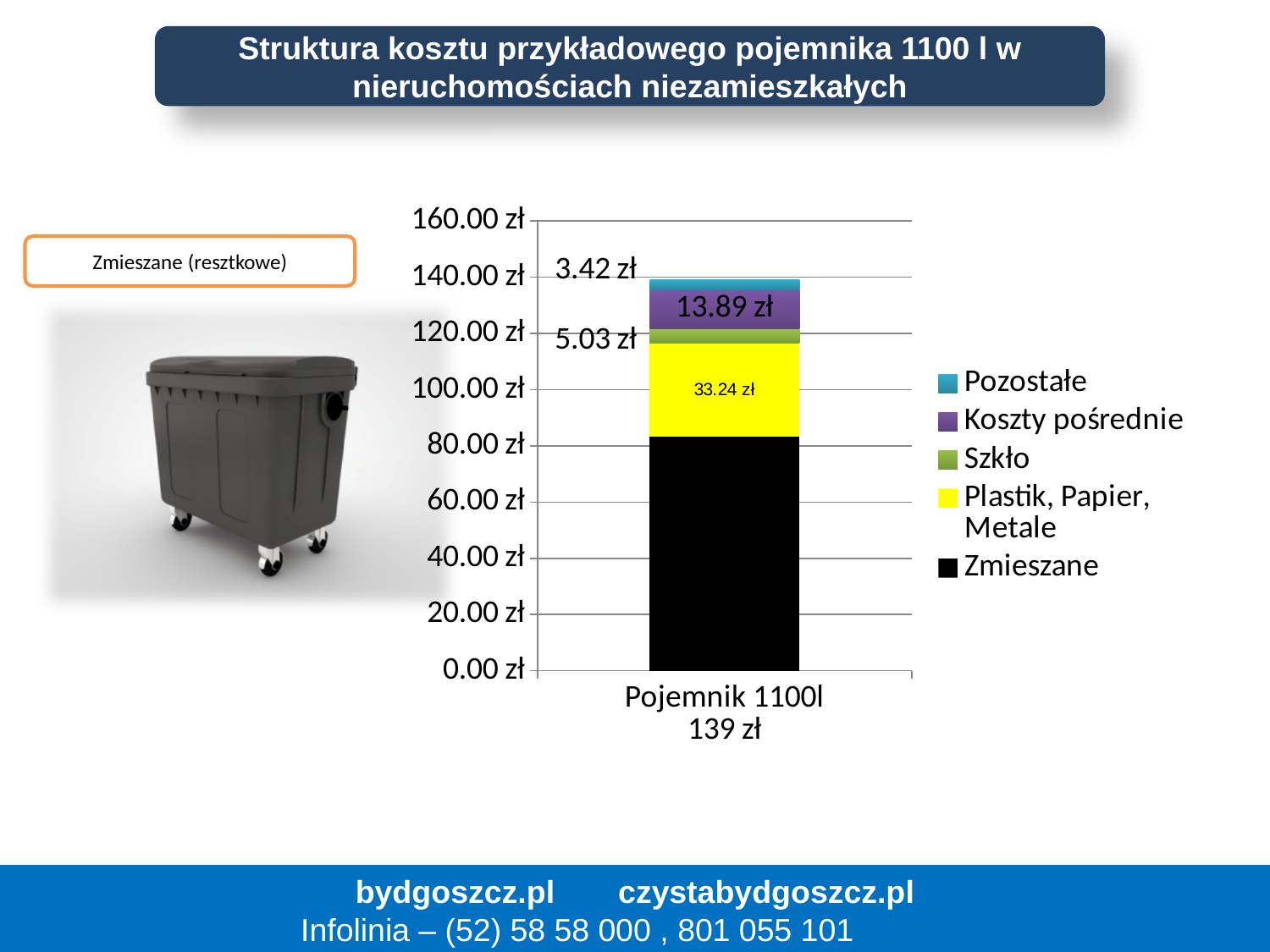
What is the total cost of the stacked bar for Pojemnik 1100l? 139 zł How many series does the chart legend list? 5 What kind of chart is shown on the slide? stacked bar chart Which series has the largest segment in the stacked bar? Zmieszane Which is larger, the Koszty pośrednie segment or the Pozostałe segment? Koszty pośrednie What is the value of the Pozostałe segment? 3.42 zł What is the value of the Plastik, Papier, Metale segment? 33.24 zł How many bars (categories) are plotted in the chart? 1 Is the value of the Zmieszane segment greater or less than 80.00 zł? greater What is the value of the Koszty pośrednie segment? 13.89 zł What is the difference between the Koszty pośrednie segment and the Szkło segment? 8.86 zł What is the value of the Szkło segment? 5.03 zł